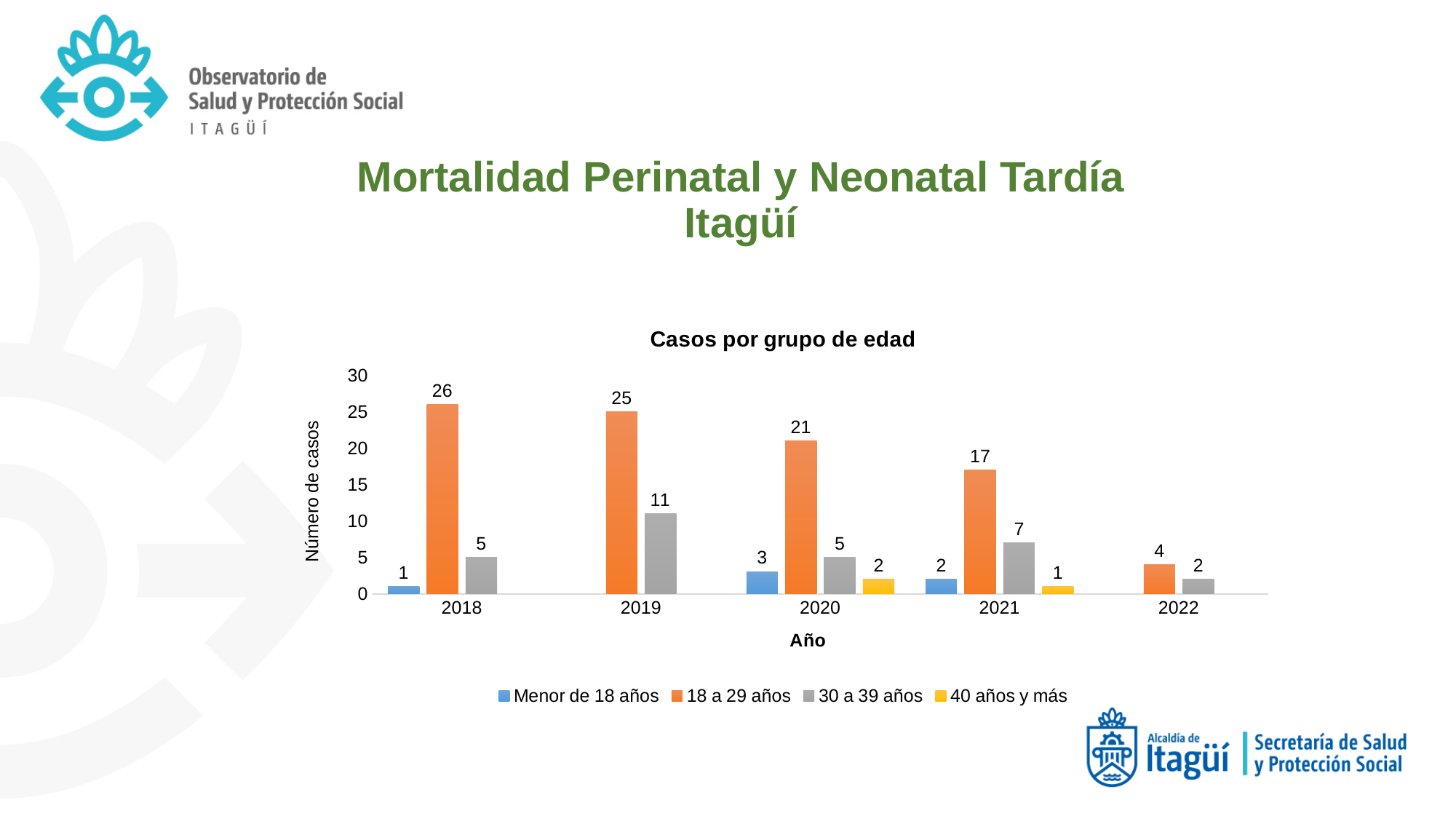
What is the difference between the 18 a 29 años values in 2018 and 2022? 22 In which year is the 18 a 29 años series lowest? 2022 What is the value for the Menor de 18 años series in 2021? 2 How many series does the legend list? 4 How many years are shown on the x axis? 5 What is the value for the 30 a 39 años series in 2019? 11 In which year is the 18 a 29 años series highest? 2018 Does the 18 a 29 años series rise or fall from 2018 to 2022? Fall What is the value for the 40 años y más series in 2020? 2 What kind of chart is shown? Bar chart What is the value for the 18 a 29 años series in 2018? 26 Which is larger: the 30 a 39 años value in 2019 or in 2021? 2019